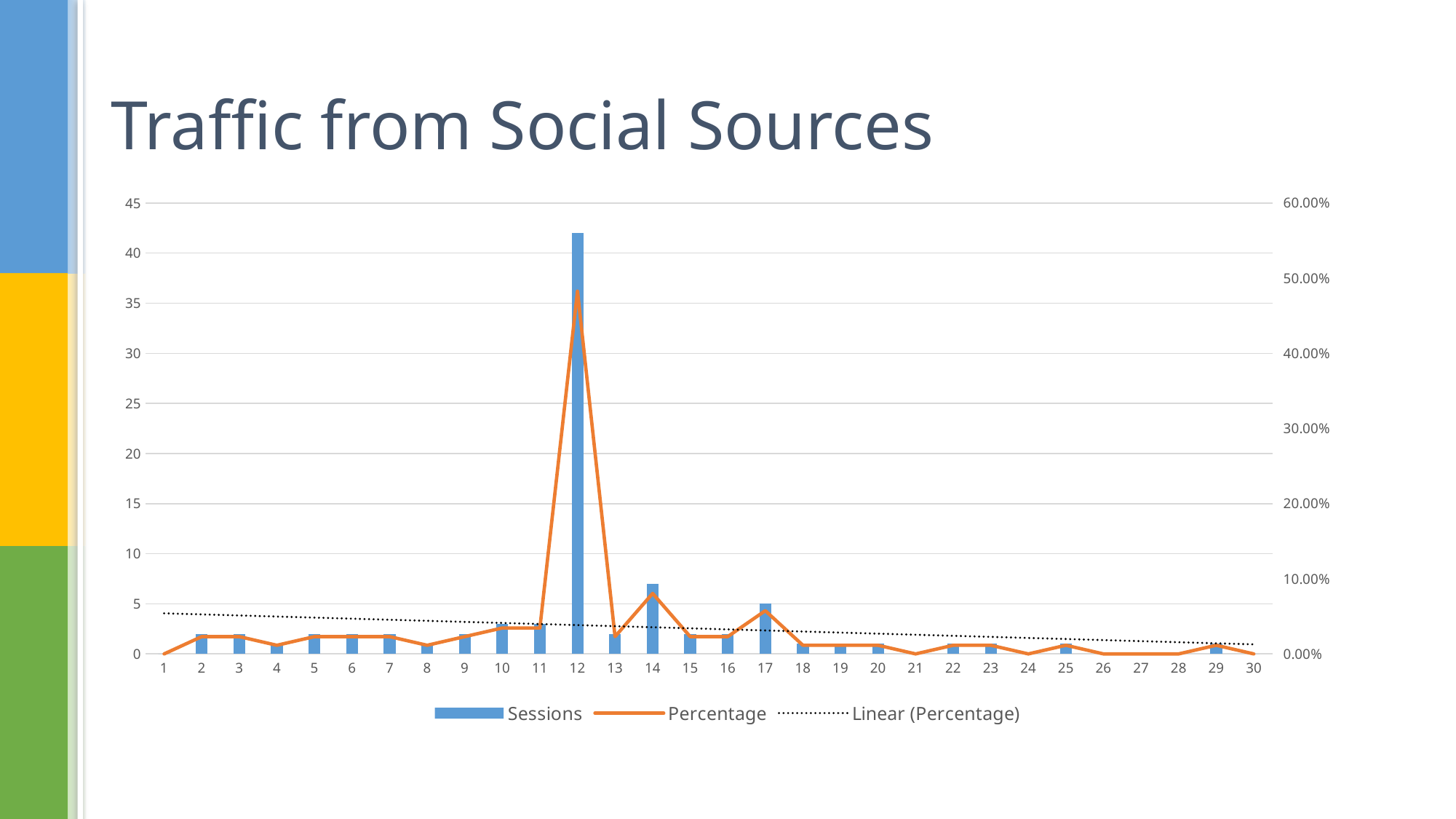
Is the Percentage value for category 12 greater or less than 40.00%? greater Is the Sessions value for category 14 greater or less than 10? less What is the title of the chart? Traffic from Social Sources How many series does the legend list? 3 What kind of chart is this? Combined bar and line chart What colour are the Sessions bars? Blue How many categories are shown on the x axis? 30 Is the Percentage value for category 17 greater or less than 10.00%? less Does the Linear (Percentage) trendline rise or fall from left to right? fall Which category has the highest Sessions value? 12 Which has the larger Sessions value, category 14 or category 17? 14